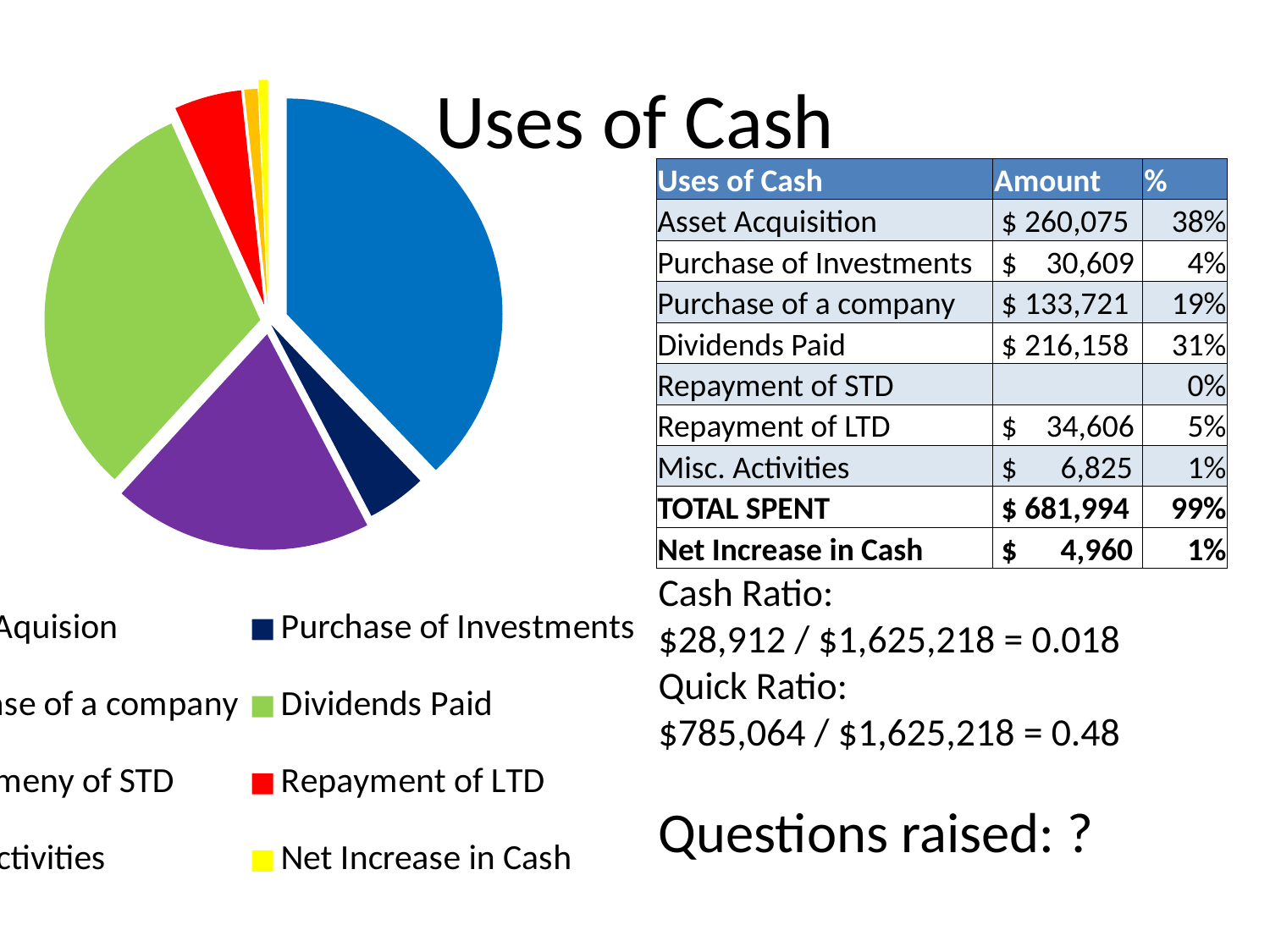
What colour is the Dividends Paid slice? green What share of the pie does Purchase of Investments represent? 4% How many categories does the legend list? 8 What is the difference between the Asset Acquisition amount and the Dividends Paid amount? $ 43,917 What share of the pie does Dividends Paid represent? 31% Which category has the smallest percentage, at 0%? Repayment of STD What is the title of the chart? Uses of Cash What is the amount for Purchase of a company? $ 133,721 What is the amount for Repayment of LTD? $ 34,606 Which is larger, Dividends Paid or Purchase of a company? Dividends Paid Which category has the largest slice of the pie? Asset Acquisition What kind of chart is shown on the slide? pie chart